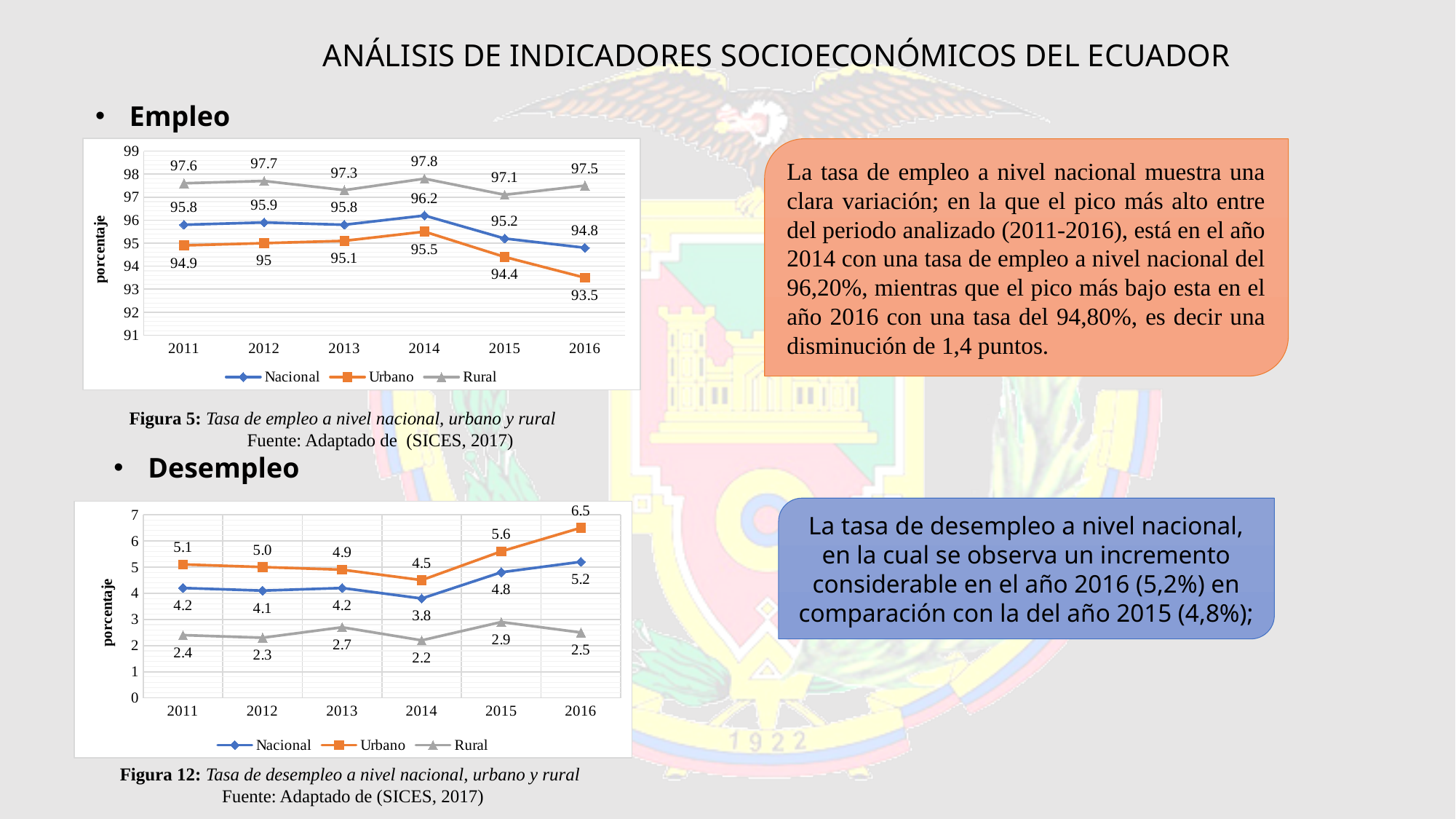
In the Desempleo (unemployment) chart, which year has the lowest Nacional value? 2014 In the Desempleo (unemployment) chart, what is the difference between the Nacional values for 2016 and 2015? 0.4 In the Empleo (employment) chart, which year has the highest Rural value? 2014 What kind of chart is the Empleo (employment) chart? Line chart In the Empleo (employment) chart, what is the Urbano value for 2016? 93.5 In the Desempleo (unemployment) chart, which is larger in 2013: the Urbano value or the Rural value? Urbano In the Desempleo (unemployment) chart, does the Urbano series rise or fall from 2014 to 2016? Rise In the Desempleo (unemployment) chart, how many years are shown on the x axis? 6 In the Empleo (employment) chart, what is the difference between the Rural and Urbano values in 2016? 4 In the Empleo (employment) chart, what is the Nacional value for 2014? 96.2 In the Empleo (employment) chart, how many series does the legend list? 3 In the Desempleo (unemployment) chart, what is the Urbano value for 2016? 6.5